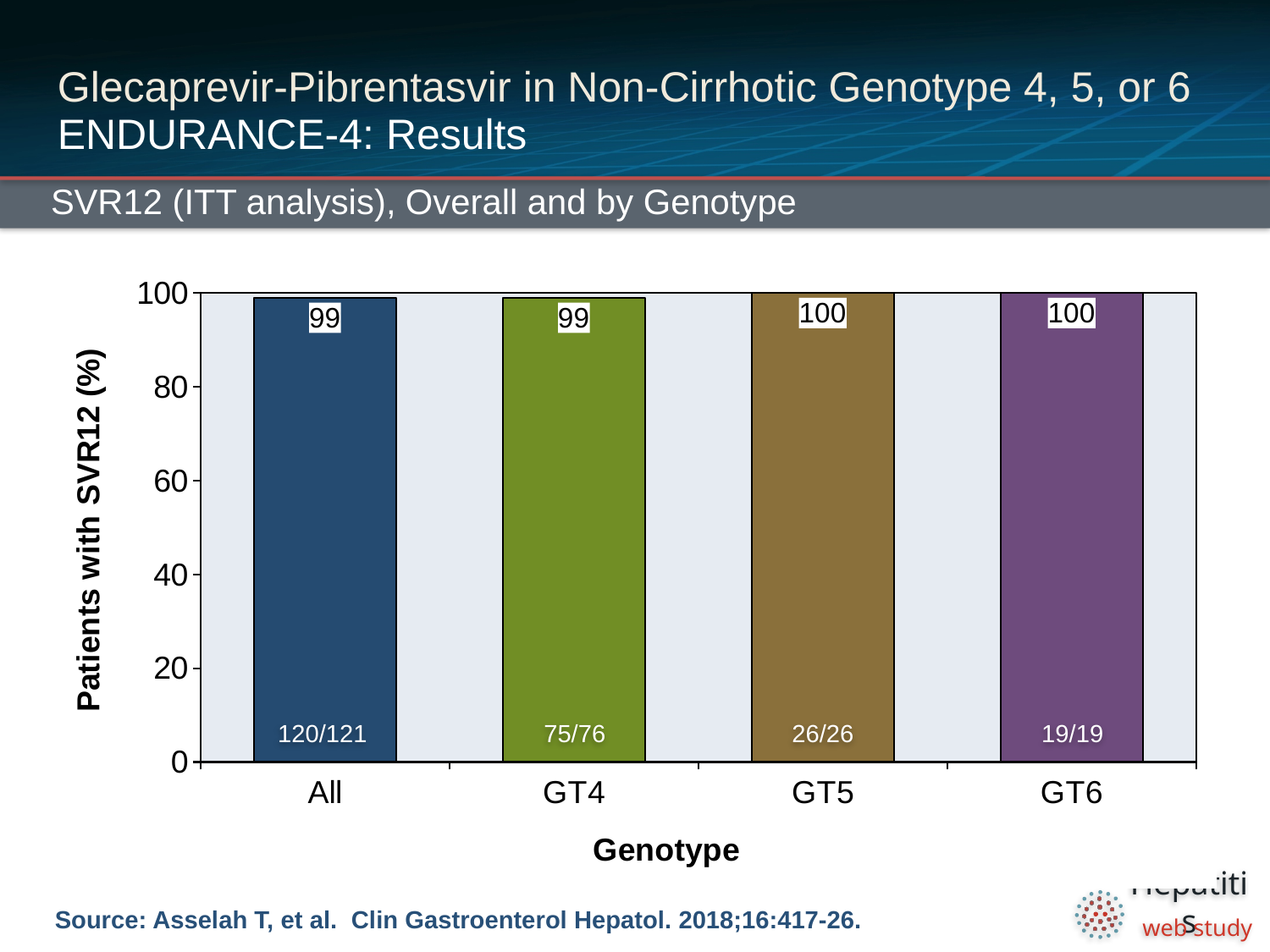
How many bars are shown in the chart? 4 What is the label of the x axis? Genotype What is the SVR12 value for GT5? 100 What kind of chart is shown on the slide? Bar chart Is the SVR12 value for GT4 greater or less than 80? greater What is the SVR12 value for the All group? 99 Which is larger, the SVR12 value for GT6 or for All? GT6 What is the SVR12 value for GT4? 99 What fraction of patients is shown inside the All bar? 120/121 What fraction of patients is shown inside the GT6 bar? 19/19 What is the label of the y axis? Patients with SVR12 (%) What is the difference between the SVR12 values for GT5 and GT4? 1